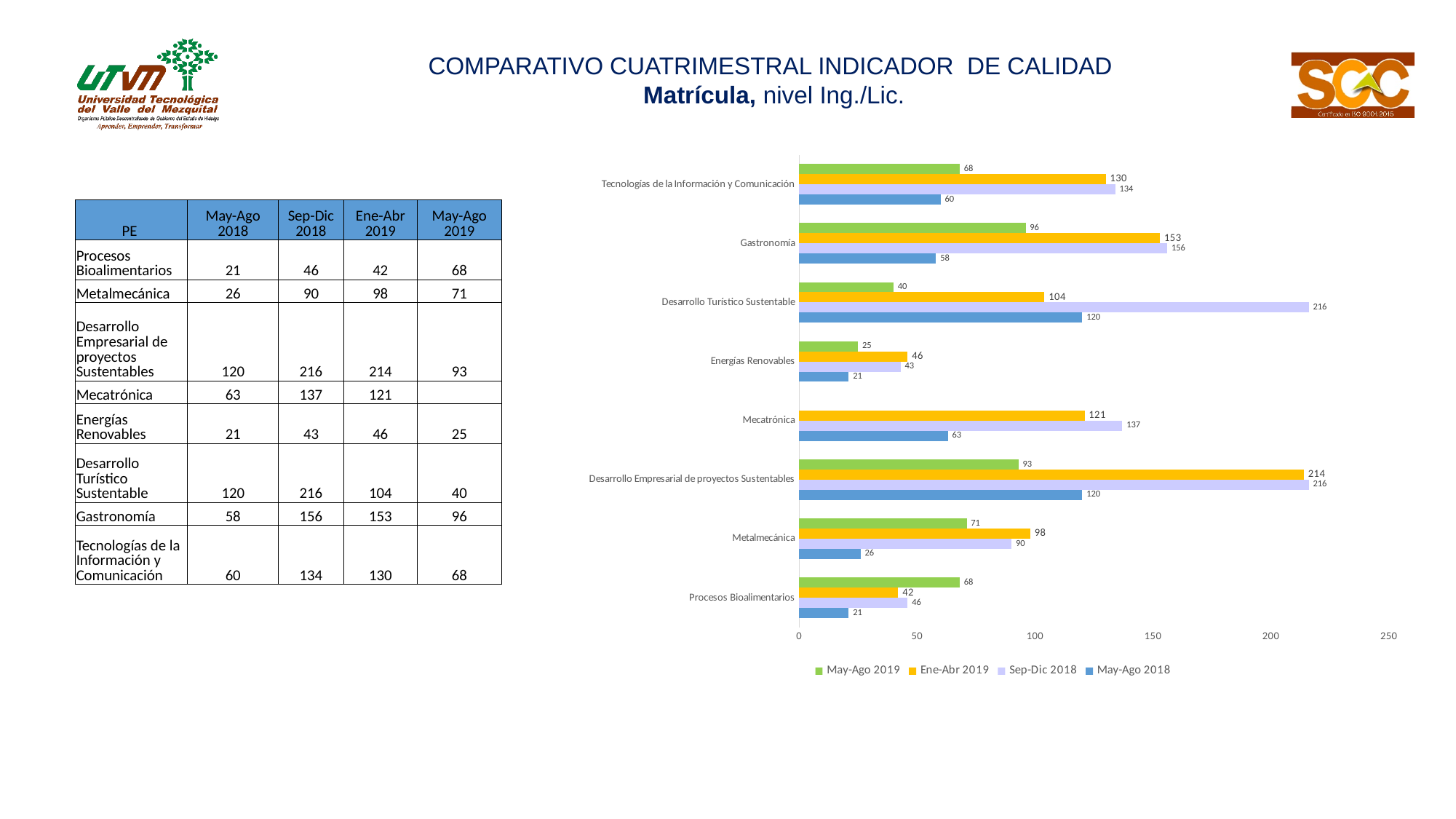
What is the Sep-Dic 2018 value for Desarrollo Turístico Sustentable? 216 What is the May-Ago 2019 value for Gastronomía? 96 How many categories are shown on the chart? 8 What kind of chart is shown on the slide? bar chart Which category has the highest Ene-Abr 2019 value? Desarrollo Empresarial de proyectos Sustentables Is the Sep-Dic 2018 value for Mecatrónica greater or less than 100? greater What is the difference between the Sep-Dic 2018 and Ene-Abr 2019 values for Desarrollo Turístico Sustentable? 112 For Metalmecánica, which is larger: the Ene-Abr 2019 value or the May-Ago 2019 value? Ene-Abr 2019 How many series does the legend list? 4 Which series is shown in green in the legend? May-Ago 2019 What is the May-Ago 2018 value for Tecnologías de la Información y Comunicación? 60 Which category has the lowest May-Ago 2018 value? Procesos Bioalimentarios and Energías Renovables (both 21)